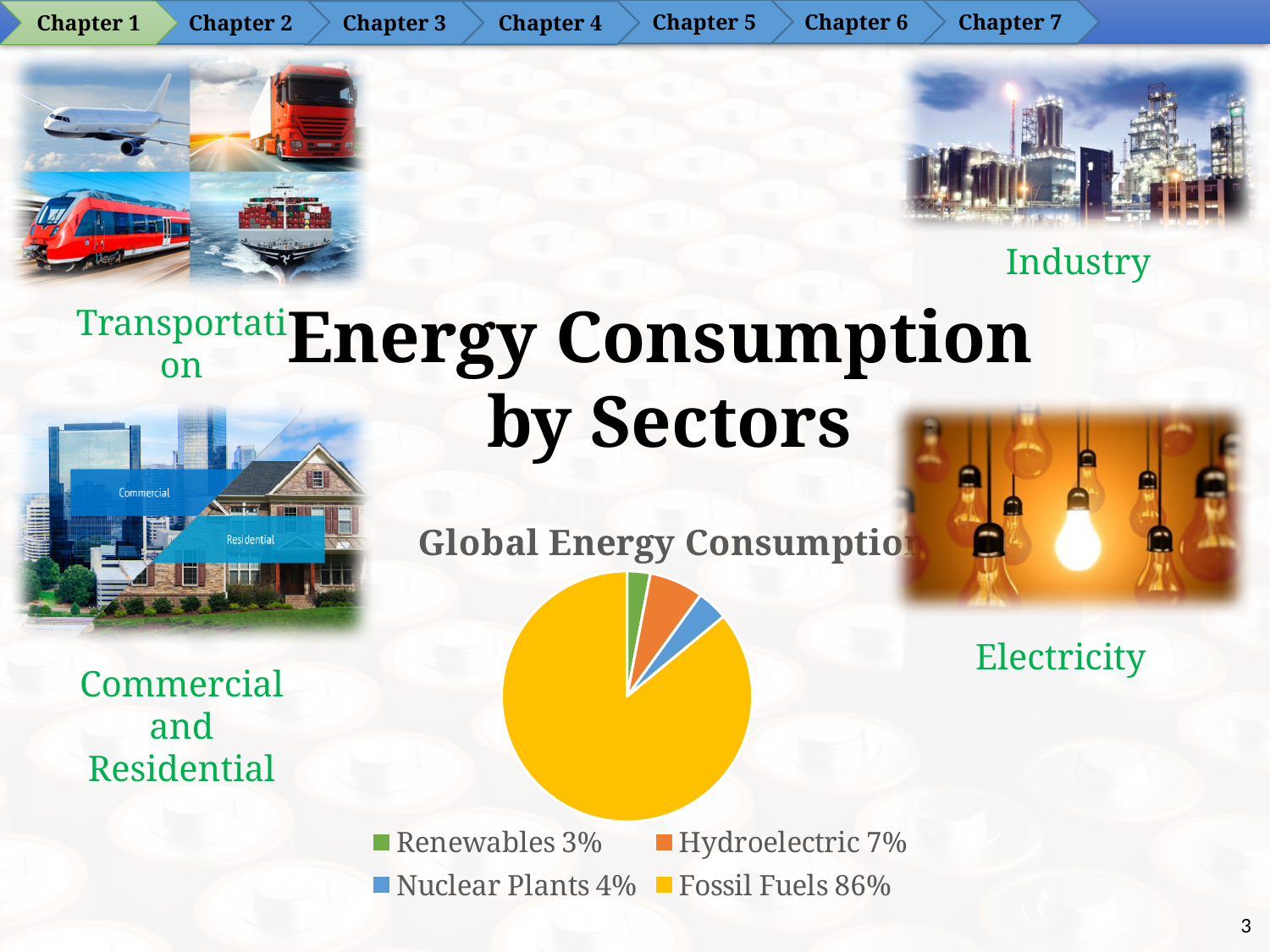
Which energy source has the largest slice of the pie? Fossil Fuels What colour is the Fossil Fuels slice in the pie chart? yellow Which is larger, the share for Hydroelectric or the share for Nuclear Plants? Hydroelectric What share of global energy consumption comes from Nuclear Plants? 4% What type of chart is shown on the slide? pie chart What is the difference in percentage points between Fossil Fuels and Hydroelectric? 79 Which energy source has the smallest slice of the pie? Renewables What share of global energy consumption comes from Renewables? 3% What share of global energy consumption comes from Fossil Fuels? 86% What is the title of the chart? Global Energy Consumption How many slices does the pie chart have? 4